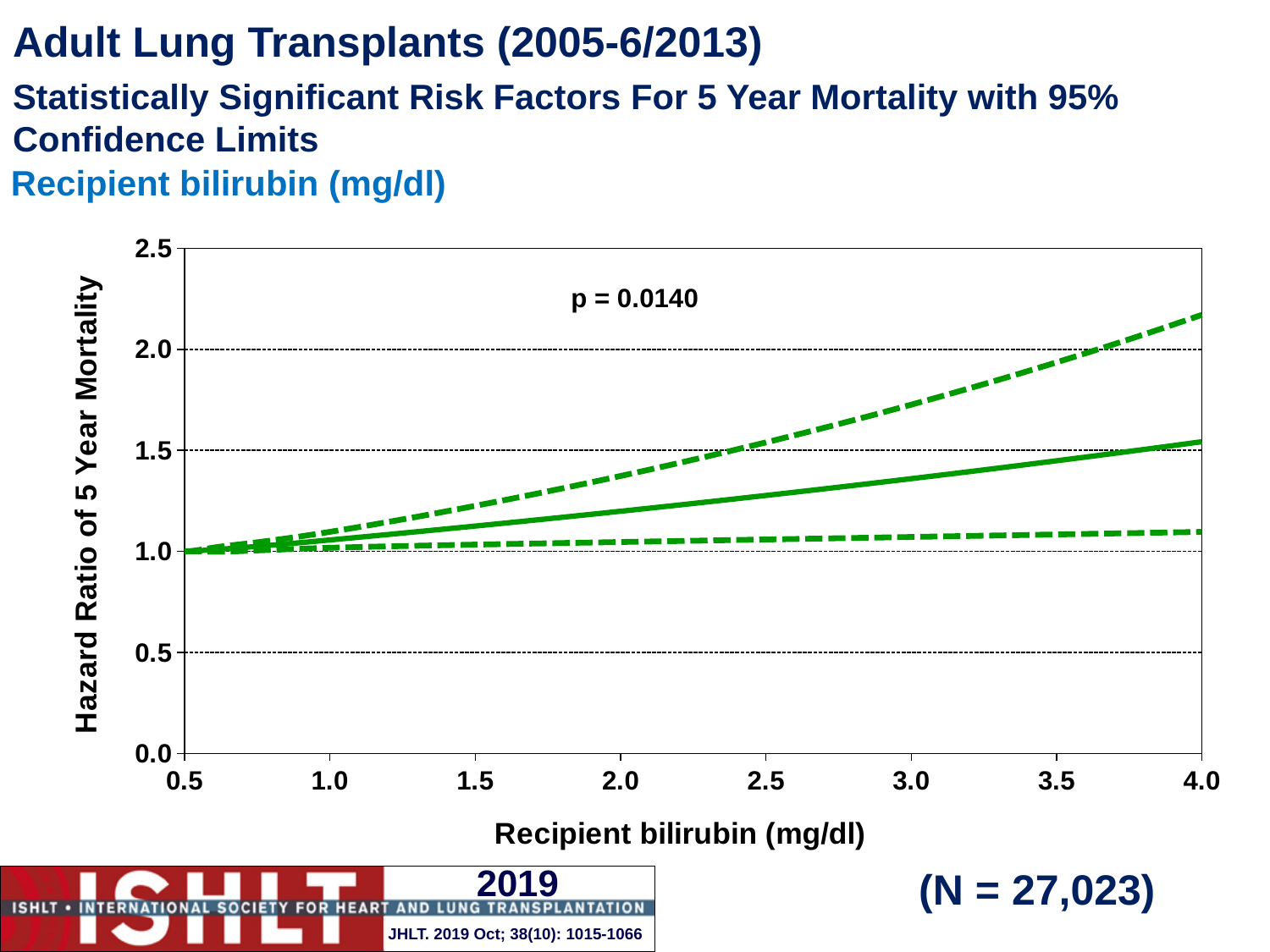
Is the upper confidence limit at a recipient bilirubin of 4.0 mg/dl greater or less than 2.0? greater Is the solid hazard ratio line at a recipient bilirubin of 3.0 mg/dl greater or less than 1.0? greater What kind of chart is shown on the slide? line chart What p-value is printed on the chart? p = 0.0140 Is the solid hazard ratio line at a recipient bilirubin of 2.0 mg/dl greater or less than 1.5? less What sample size (N) is shown on the slide? N = 27,023 What is the highest value shown on the x axis? 4.0 What is the label of the y axis? Hazard Ratio of 5 Year Mortality Does the solid hazard ratio line rise or fall as recipient bilirubin increases from 0.5 to 4.0 mg/dl? rise How many lines are plotted on the chart? 3